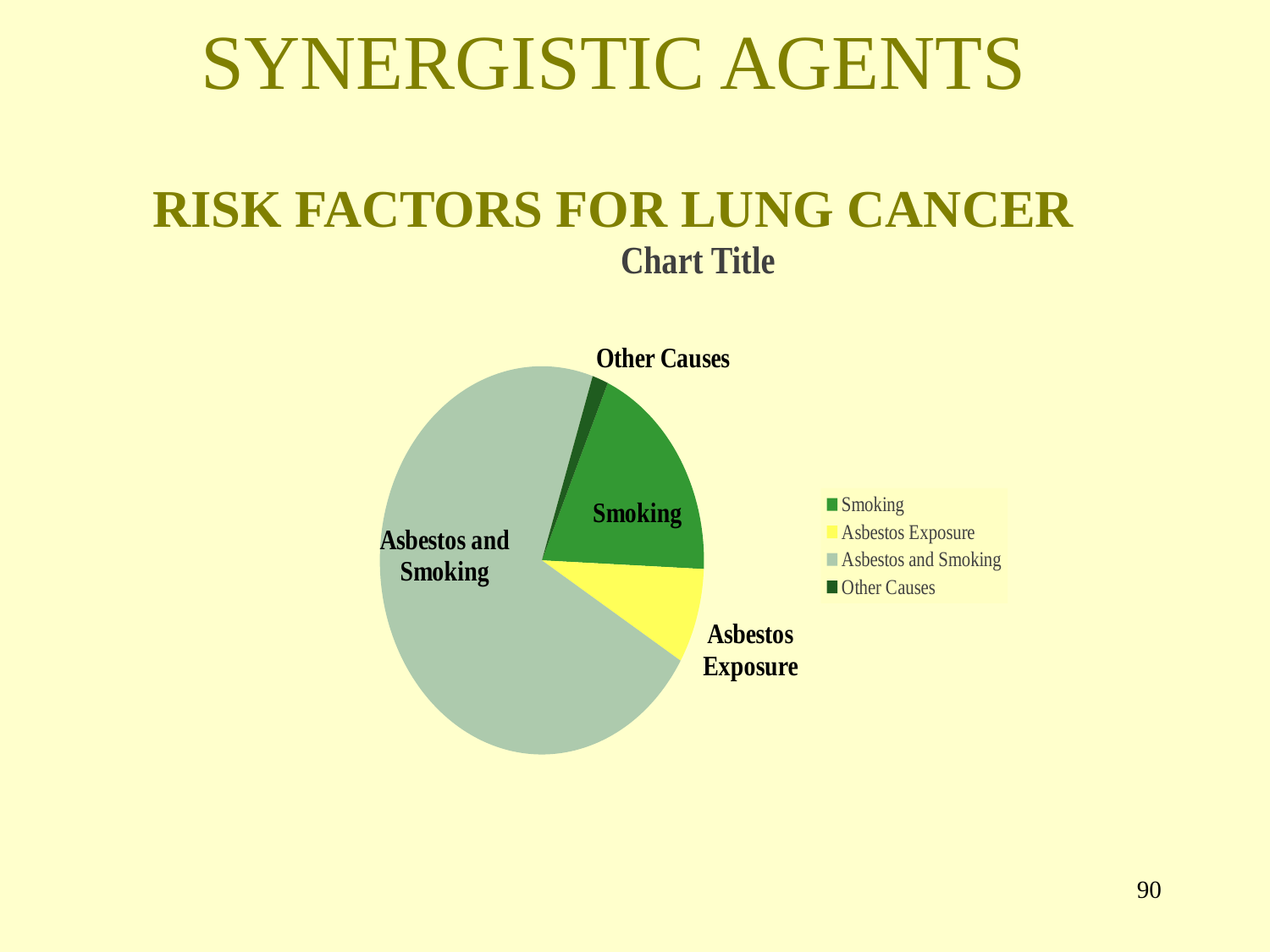
How many entries does the legend of the pie chart list? 4 How many slices does the pie chart have? 4 Which slice is larger, Asbestos Exposure or Other Causes? Asbestos Exposure Which category has the largest slice of the pie chart? Asbestos and Smoking What kind of chart is shown on the slide? Pie chart Which slice is larger, Smoking or Asbestos Exposure? Smoking Which category is shown in yellow in the pie chart? Asbestos Exposure Which category has the smallest slice of the pie chart? Other Causes What is the title printed above the pie chart? Chart Title Which slice is larger, Asbestos and Smoking or Smoking? Asbestos and Smoking